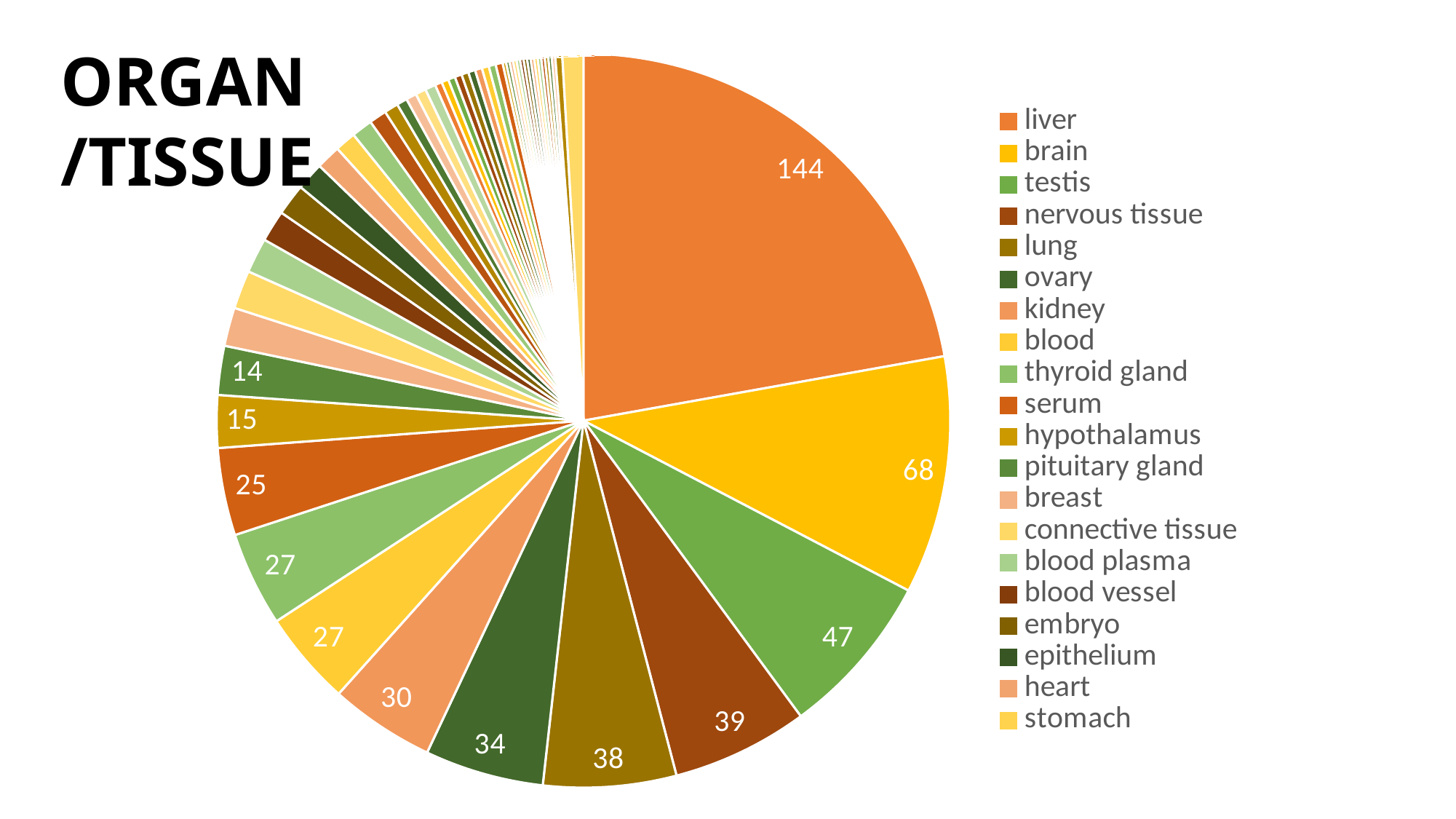
How many entries does the legend list? 20 What is the value for kidney? 30 What is the value for liver? 144 Which is larger, the value for lung or the value for ovary? lung What is the difference between the values for liver and brain? 76 What is the value for testis? 47 Which category has the largest slice? liver What is the value for brain? 68 What is the value for nervous tissue? 39 What is the value for hypothalamus? 15 What is the value for ovary? 34 What type of chart is shown on the slide? pie chart